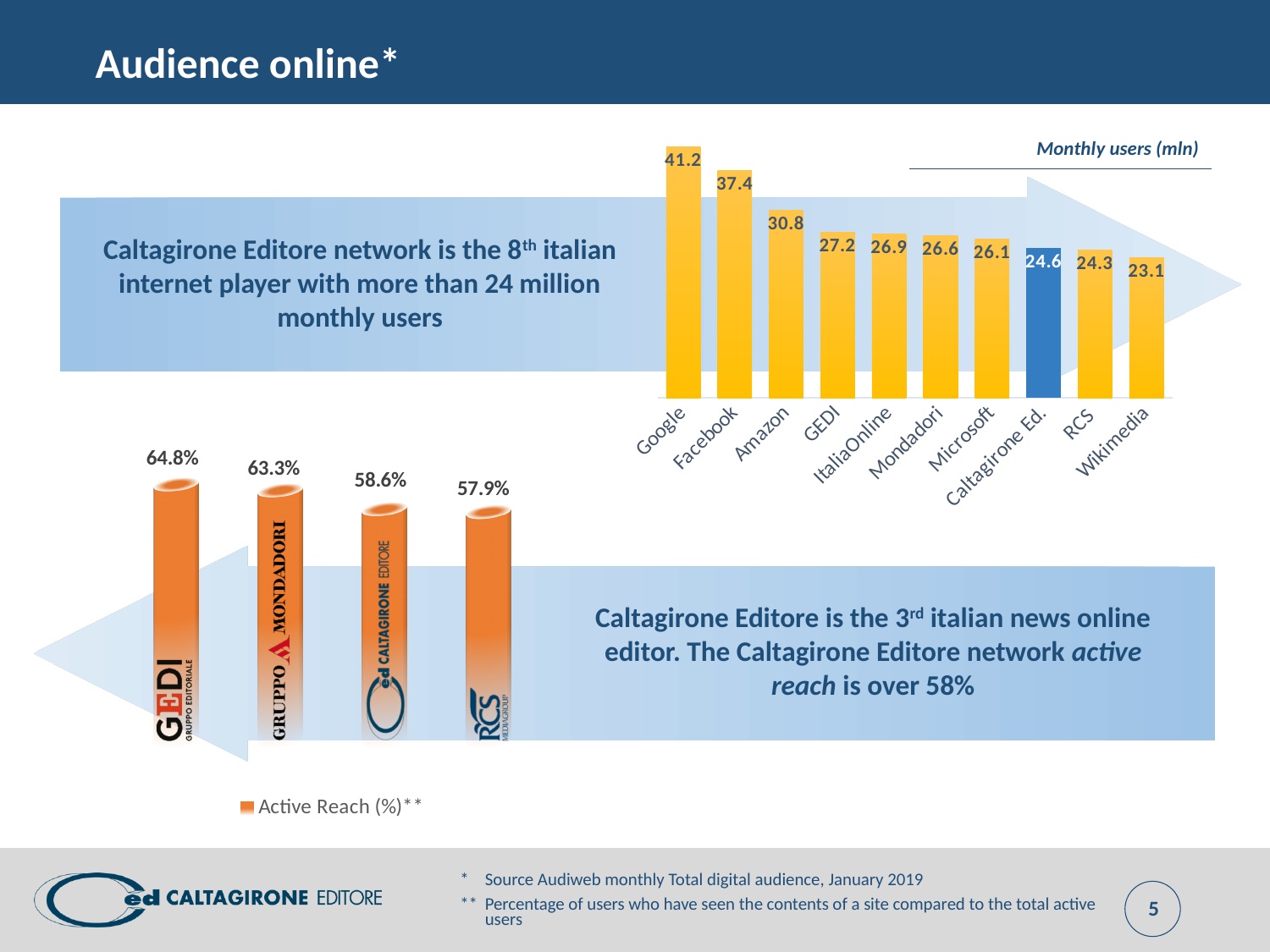
How many categories are shown in the Monthly users (mln) chart? 10 In the Monthly users (mln) chart, which category has the lowest value? Wikimedia In the Active Reach (%) chart at the bottom left, what is the value of the first (leftmost) bar, labelled with the GEDI logo? 64.8% In the Monthly users (mln) chart, what is the value for Amazon? 30.8 In the Monthly users (mln) chart, which is larger, GEDI or Mondadori? GEDI In the Monthly users (mln) chart, what is the value for Caltagirone Ed.? 24.6 In the Active Reach (%) chart at the bottom left, what is the value of the bar labelled with the Caltagirone Editore logo? 58.6% In the Monthly users (mln) chart, what is the value for Google? 41.2 In the Monthly users (mln) chart, what is the difference between Google and Facebook? 3.8 In the Monthly users (mln) chart, which category has the highest value? Google What kind of chart is the Monthly users (mln) chart? Bar chart In the Monthly users (mln) chart, do the values rise or fall from left to right? Fall